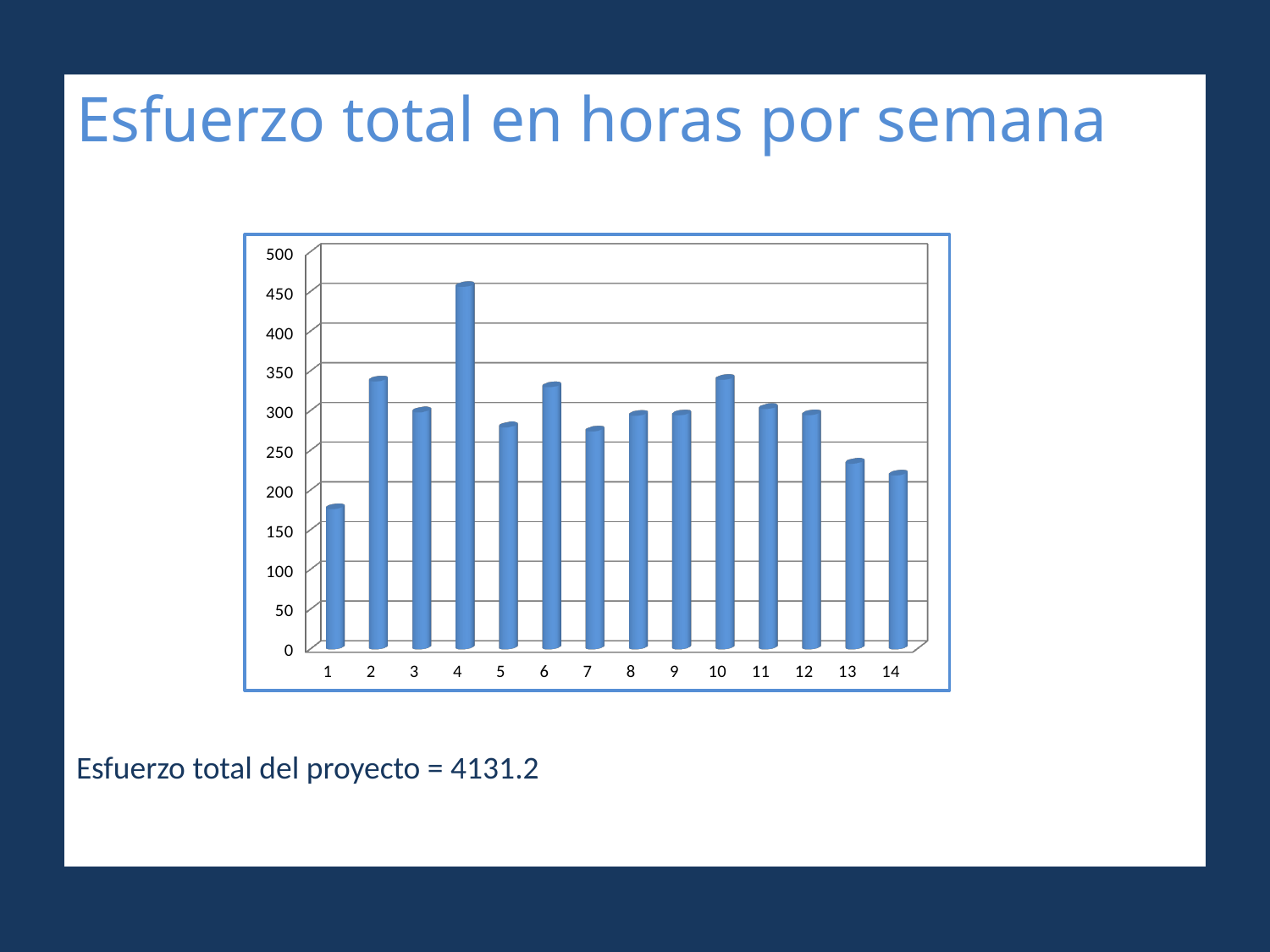
Which is larger, the value for week 1 or the value for week 14? week 14 Which week has the highest total effort? 4 What is the title of the slide containing the chart? Esfuerzo total en horas por semana Is the value for week 1 greater or less than 200? less Which is larger, the value for week 4 or the value for week 2? week 4 Is the value for week 13 greater or less than 250? less What kind of chart is shown on the slide? bar chart Which week has the lowest total effort? 1 How many weeks (categories) are plotted on the x axis? 14 Do the values rise or fall from week 10 to week 14? fall Is the value for week 4 greater or less than 400? greater